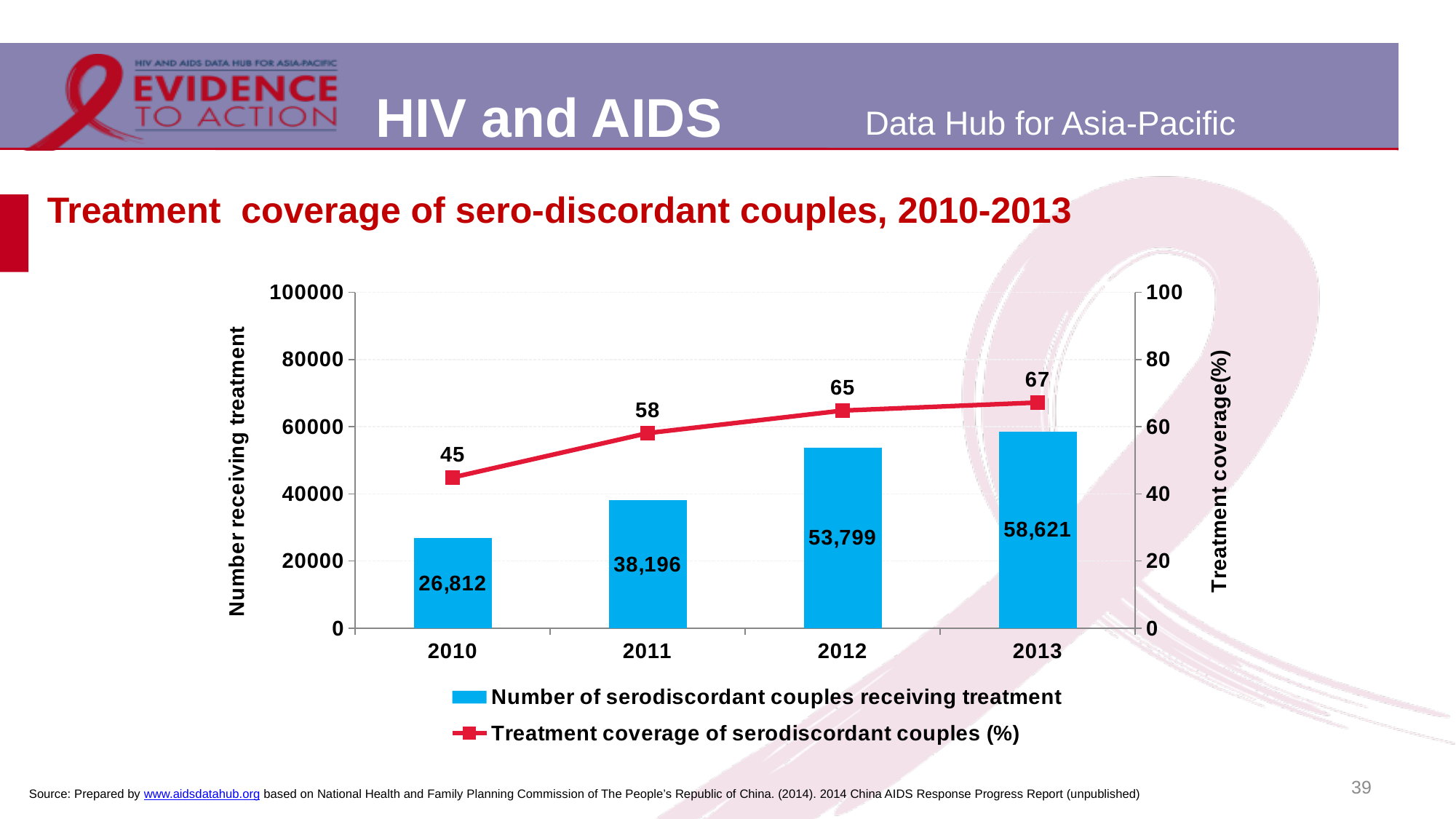
How many serodiscordant couples were receiving treatment in 2013? 58,621 How many serodiscordant couples were receiving treatment in 2010? 26,812 Which year has the highest number of serodiscordant couples receiving treatment? 2013 Is the number of serodiscordant couples receiving treatment in 2012 greater or less than 40000? greater How many years are shown on the x axis of the chart? 4 By how many percentage points did treatment coverage of serodiscordant couples rise from 2010 to 2013? 22 Which year had more serodiscordant couples receiving treatment, 2011 or 2012? 2012 What was the treatment coverage of serodiscordant couples (%) in 2012? 65 Which year has the lowest treatment coverage of serodiscordant couples (%)? 2010 How many series does the chart legend list? 2 What is the difference in the number of serodiscordant couples receiving treatment between 2011 and 2010? 11,384 Does the treatment coverage of serodiscordant couples (%) rise or fall from 2010 to 2013? rise